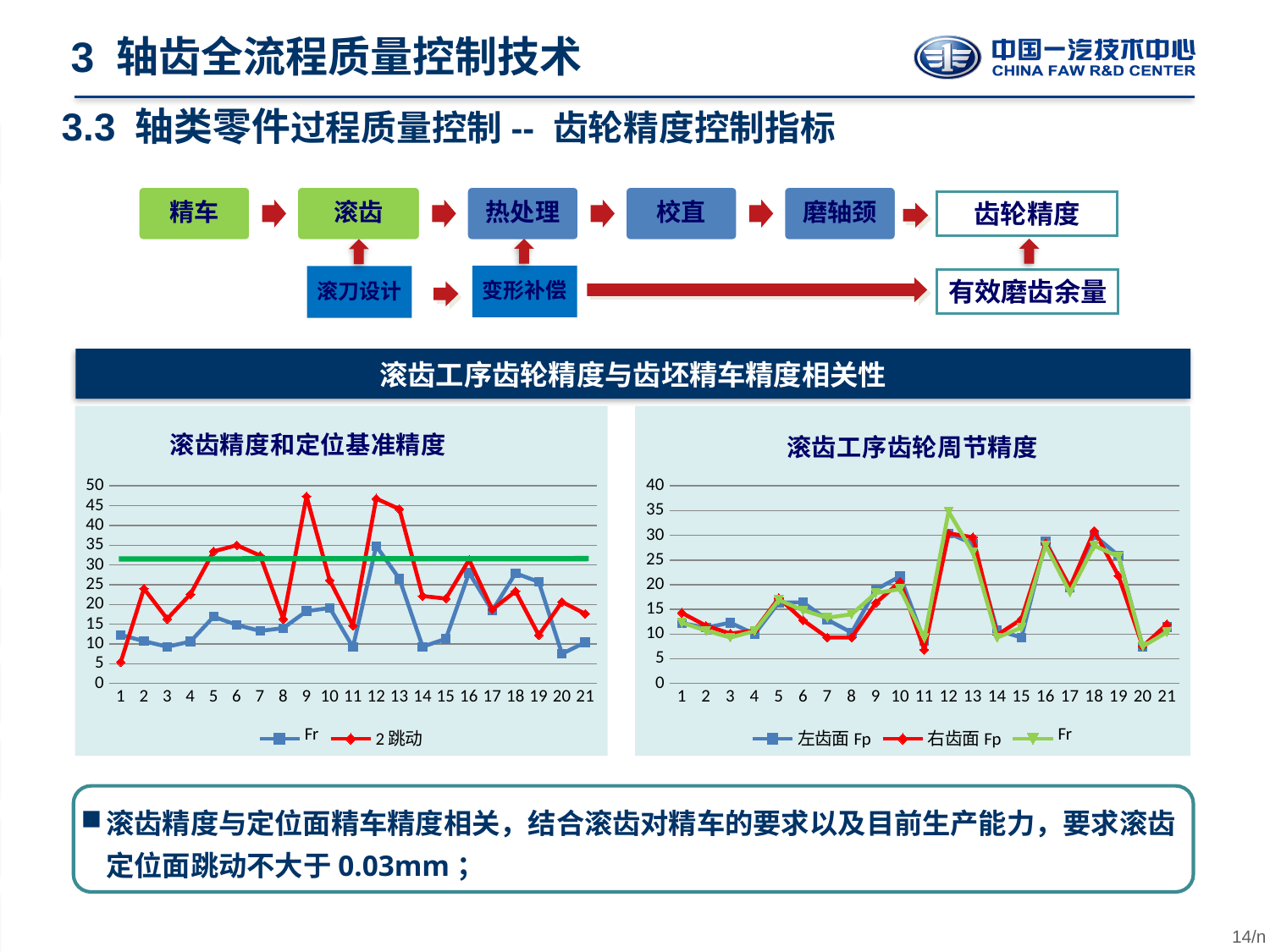
In the left chart titled 滚齿精度和定位基准精度, is the value of 2 跳动 at point 9 greater or less than 40? greater In the right chart titled 滚齿工序齿轮周节精度, is the value of Fr at point 12 greater or less than 30? greater How many series does the legend of the left chart titled 滚齿精度和定位基准精度 list? 2 In the left chart titled 滚齿精度和定位基准精度, is the value of Fr at point 12 greater or less than 30? greater What kind of chart is the left chart titled 滚齿精度和定位基准精度? line chart In the right chart titled 滚齿工序齿轮周节精度, at which x-axis point does the Fr series reach its highest value? 12 How many points are plotted along the x axis of the right chart titled 滚齿工序齿轮周节精度? 21 How many series does the legend of the right chart titled 滚齿工序齿轮周节精度 list? 3 What is the title of the right chart on the slide? 滚齿工序齿轮周节精度 In the left chart titled 滚齿精度和定位基准精度, at which x-axis point does the Fr series reach its highest value? 12